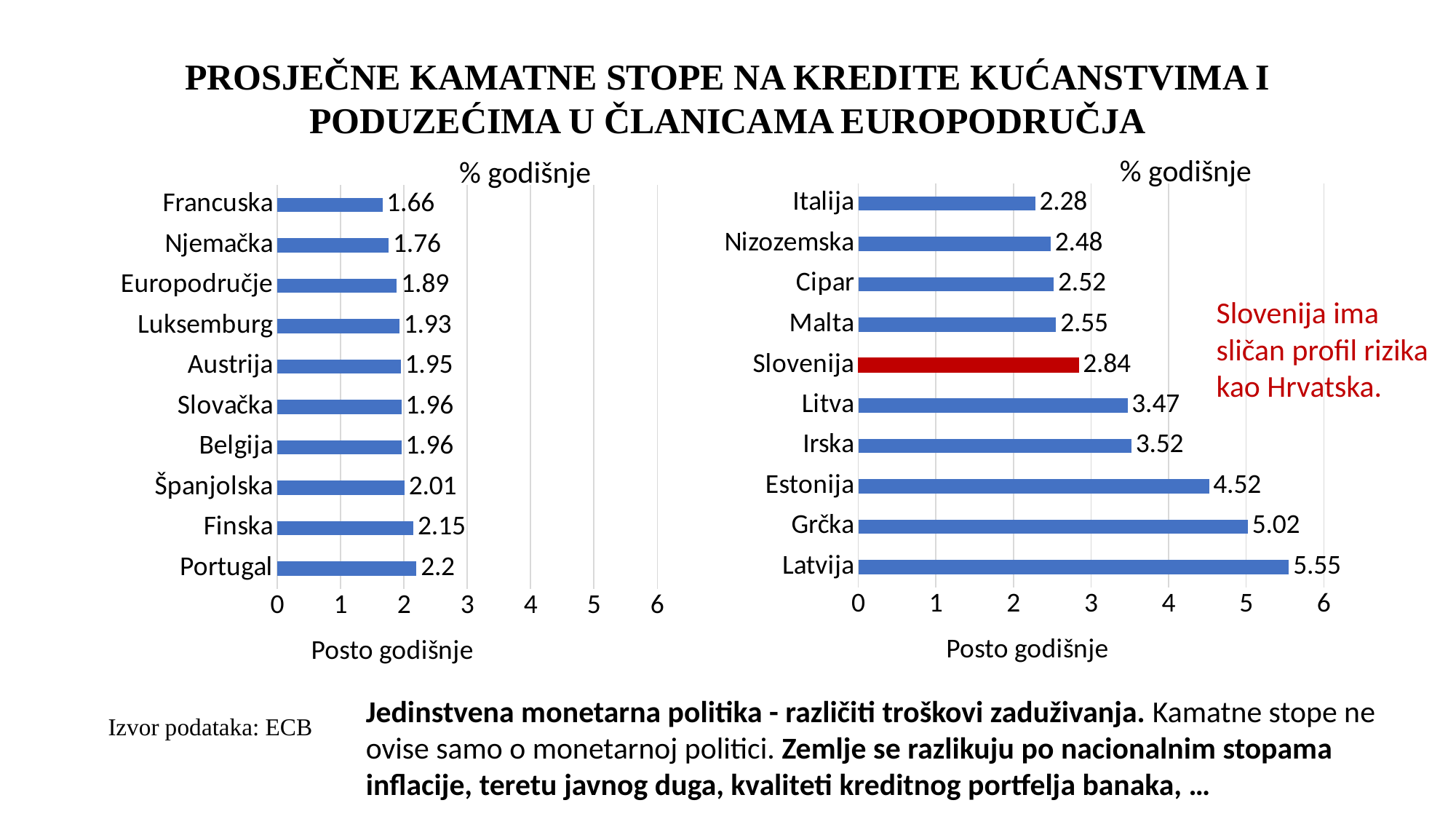
In the right chart, is the value for Estonija greater or less than 4? greater In the left chart, what is the value for Francuska? 1.66 In the right chart, which bar is coloured red instead of blue? Slovenija In the right chart, what is the difference between the values for Latvija and Italija? 3.27 In the right chart, which country has the highest value? Latvija What kind of chart is the right chart? bar chart In the right chart, what is the value for Grčka? 5.02 In the left chart, which is larger, the value for Portugal or the value for Finska? Portugal In the left chart, which category has the lowest value? Francuska What is the x-axis title of the left chart? Posto godišnje How many categories are shown in the left chart? 10 In the right chart, what is the value for Slovenija? 2.84